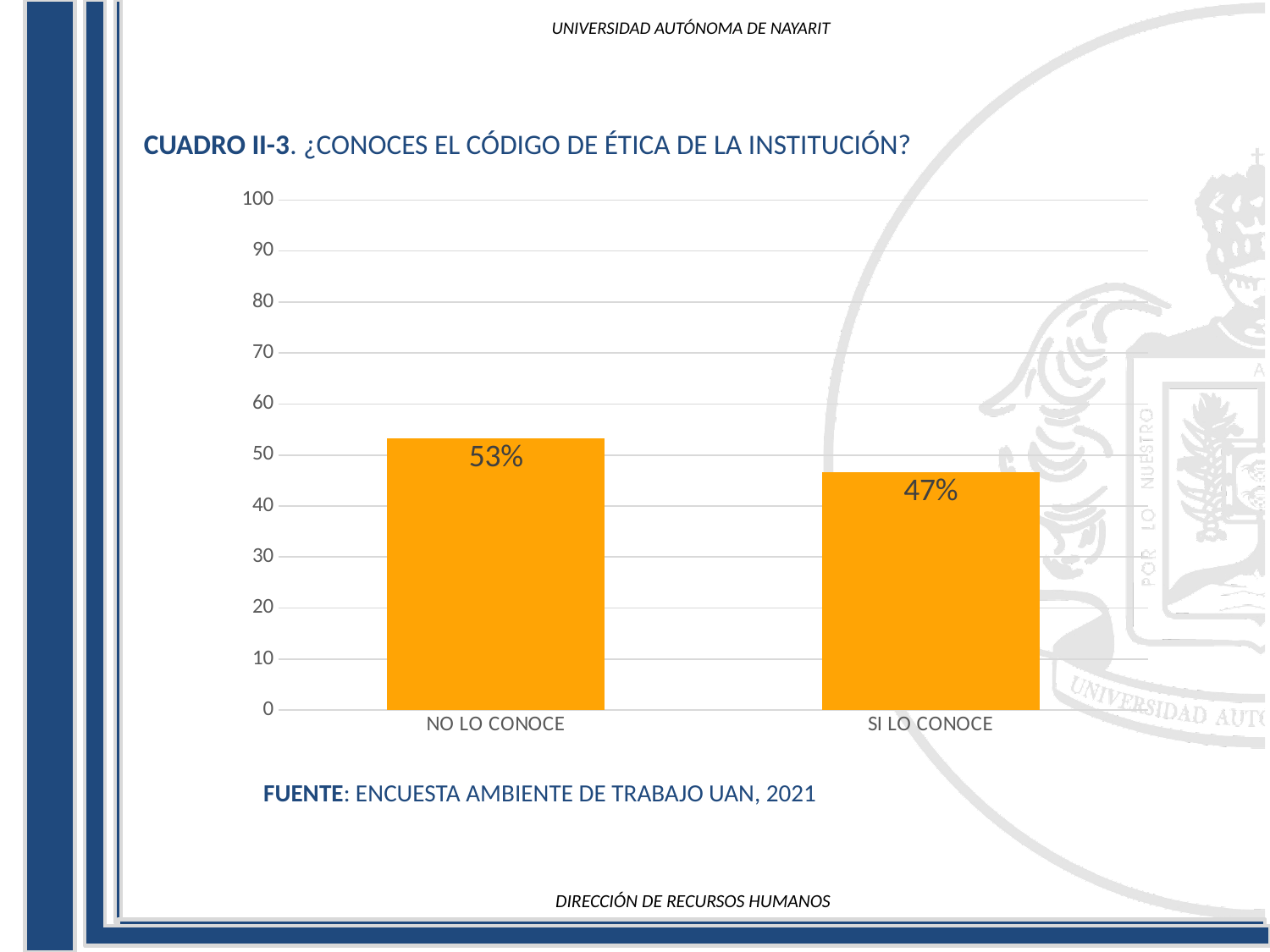
What is the source cited below the chart? ENCUESTA AMBIENTE DE TRABAJO UAN, 2021 Which category has the highest value? NO LO CONOCE How many categories are shown in the chart? 2 What is the value for SI LO CONOCE? 47% Is the value for NO LO CONOCE greater or less than 50? greater What is the title of the chart? CUADRO II-3. ¿CONOCES EL CÓDIGO DE ÉTICA DE LA INSTITUCIÓN? Which category has the lowest value? SI LO CONOCE Which is larger, the value for NO LO CONOCE or the value for SI LO CONOCE? NO LO CONOCE Is the value for SI LO CONOCE greater or less than 50? less What is the difference between the values for NO LO CONOCE and SI LO CONOCE? 6% What kind of chart is shown on the slide? bar chart What is the value for NO LO CONOCE? 53%